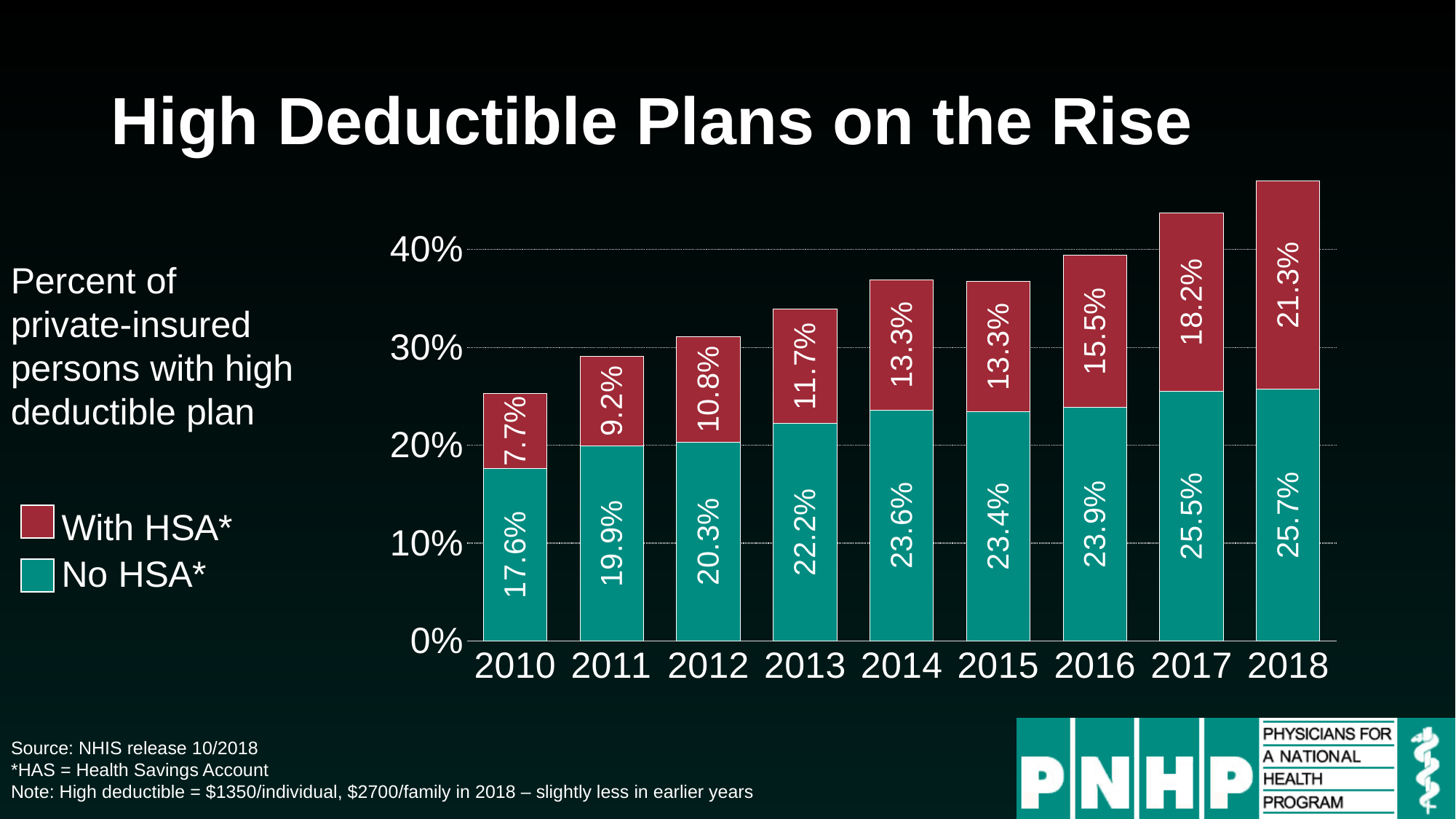
What is the With HSA* value for 2018? 21.3% Which is larger, the With HSA* value for 2016 or for 2015? 2016 What is the With HSA* value for 2013? 11.7% What kind of chart is shown on the slide? Stacked bar chart What is the No HSA* value for 2010? 17.6% How many years are shown on the x axis? 9 Which year has the highest With HSA* value? 2018 How many series does the legend list? 2 What is the difference between the No HSA* values for 2018 and 2010? 8.1 percentage points Which year has the lowest No HSA* value? 2010 What is the total of the stacked bar for 2018? 47.0% What is the total of the stacked bar for 2010? 25.3%